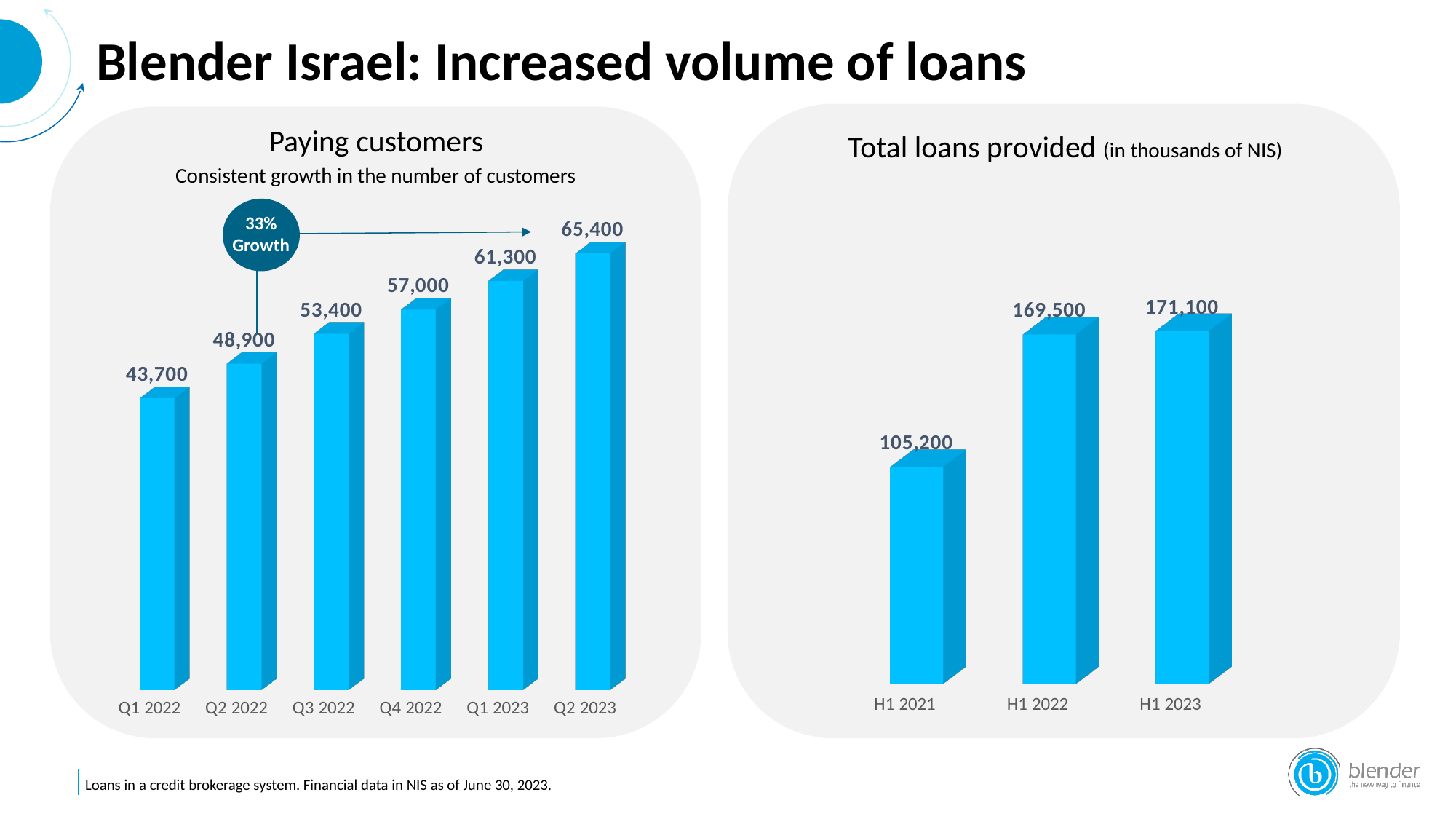
What kind of chart is the 'Total loans provided' chart? bar chart In the 'Total loans provided' chart, what is the value for H1 2021? 105,200 In the 'Paying customers' chart, what is the difference between Q2 2023 and Q1 2023? 4,100 In the 'Paying customers' chart, what is the value for Q4 2022? 57,000 In the 'Paying customers' chart, what is the value for Q1 2022? 43,700 In the 'Total loans provided' chart, which is larger, H1 2021 or H1 2022? H1 2022 In the 'Total loans provided' chart, what is the value for H1 2023? 171,100 In the 'Paying customers' chart, do the values rise or fall from Q1 2022 to Q2 2023? rise In the 'Paying customers' chart, which quarter has the highest value? Q2 2023 In the 'Paying customers' chart, which quarter has the lowest value? Q1 2022 In the 'Total loans provided' chart, what is the difference between H1 2022 and H1 2021? 64,300 In the 'Paying customers' chart, how many quarters are shown? 6